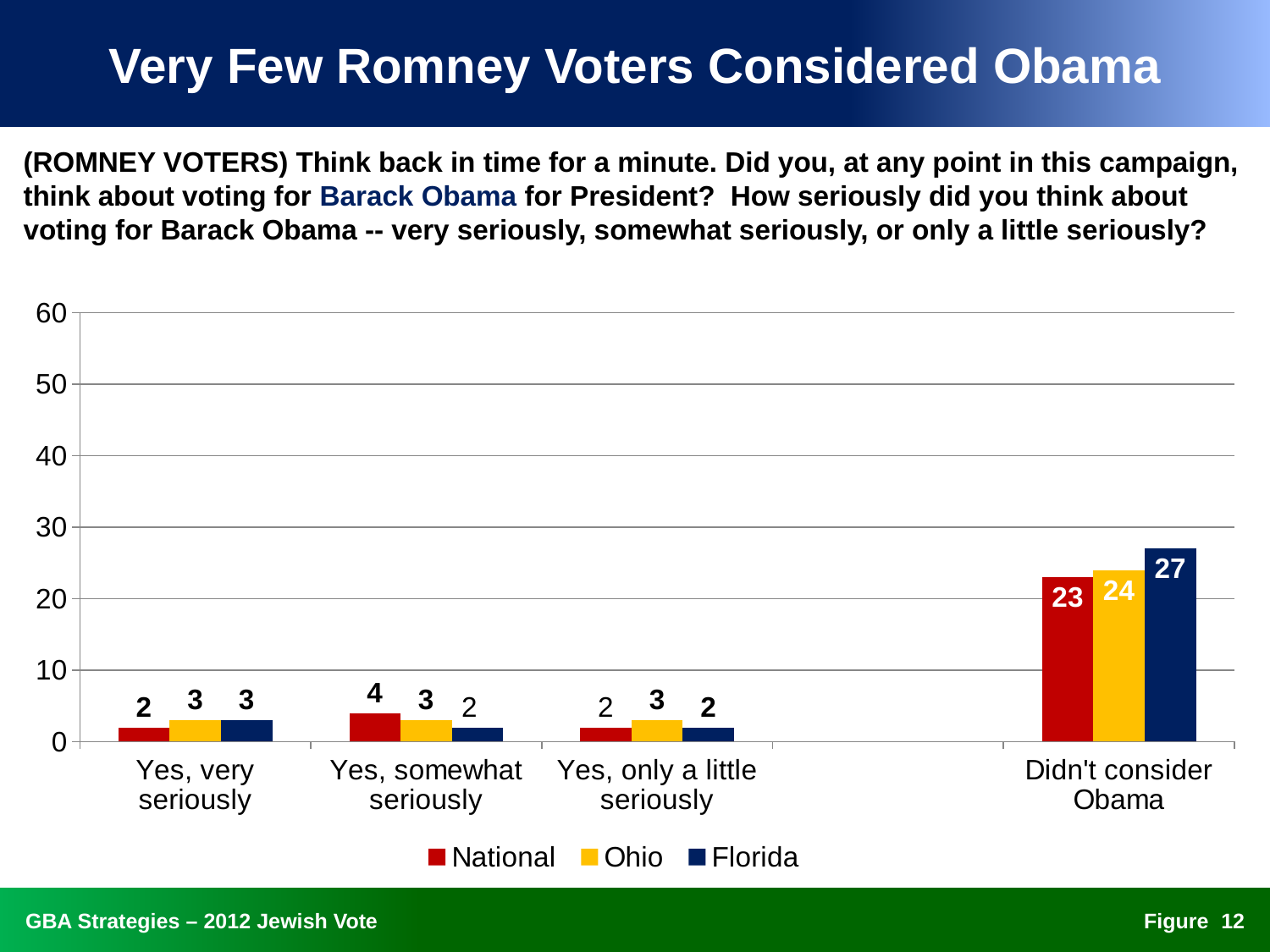
What is the Ohio value for "Didn't consider Obama"? 24 What is the Florida value for "Didn't consider Obama"? 27 How many series does the legend list? 3 What is the National value for "Didn't consider Obama"? 23 What is the difference between the Florida and National values for "Didn't consider Obama"? 4 Which series is shown in yellow in the legend? Ohio What is the National value for "Yes, somewhat seriously"? 4 Is the Florida value for "Didn't consider Obama" greater or less than 30? less Which category has the highest Florida value? Didn't consider Obama What kind of chart is shown on the slide? bar chart What is the Ohio value for "Yes, very seriously"? 3 For "Didn't consider Obama", which is larger, the Ohio value or the Florida value? Florida